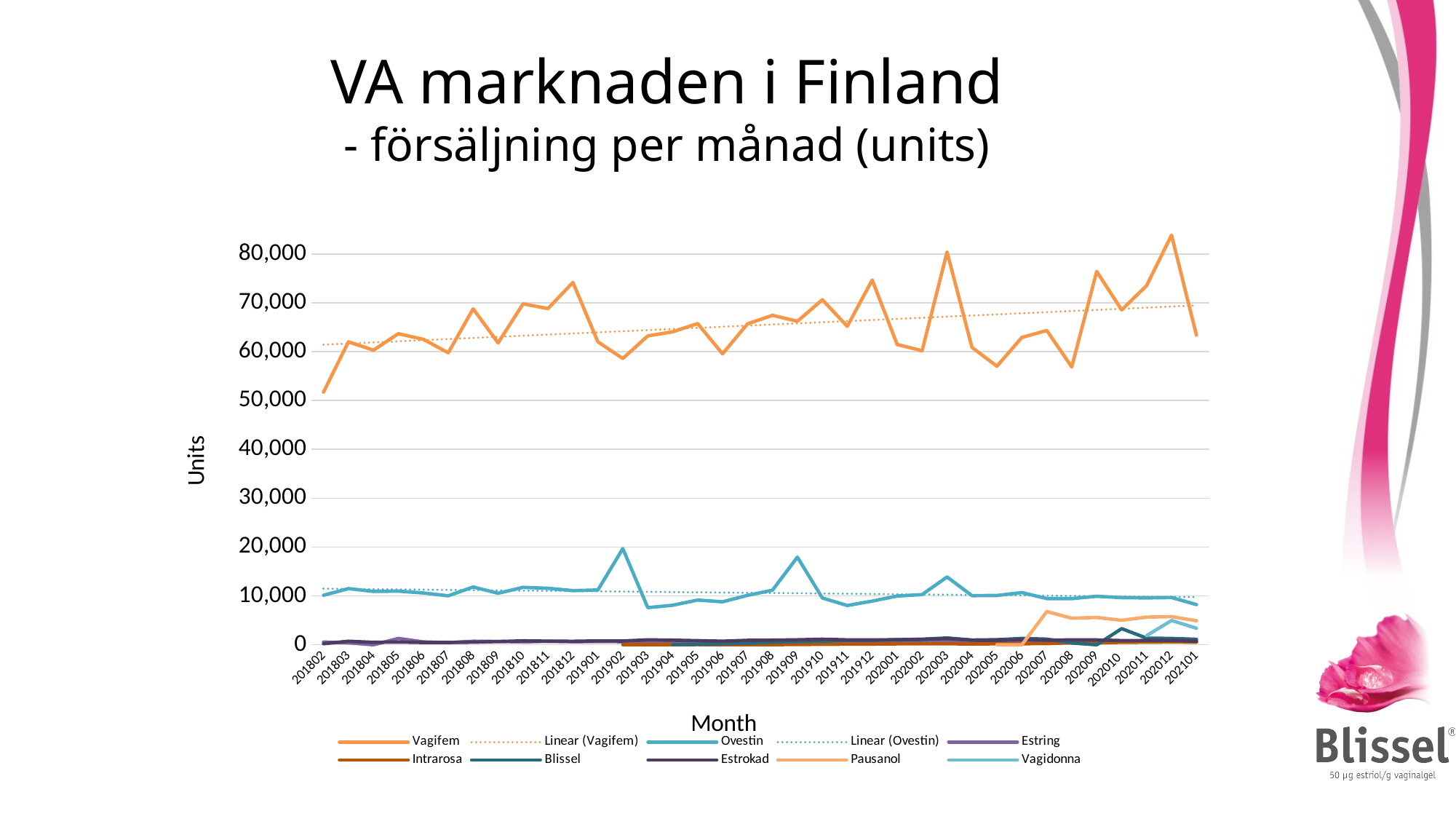
Is the value for Vagifem in 202005 greater or less than 60,000? less What kind of chart is shown on the slide? line chart How many months are shown along the x axis of the chart? 36 Is the value for Vagifem in 202012 greater or less than 80,000? greater In which month does Vagifem have its lowest value? 201802 How many entries does the chart legend list? 10 Does the Linear (Vagifem) trendline rise or fall from left to right? rise Is the value for Ovestin in 201903 greater or less than 10,000? less In which month does Vagifem reach its highest value? 202012 What is the title of the vertical axis of the chart? Units Which series has the highest values throughout the chart? Vagifem Which is larger in 201909, the value for Vagifem or the value for Ovestin? Vagifem